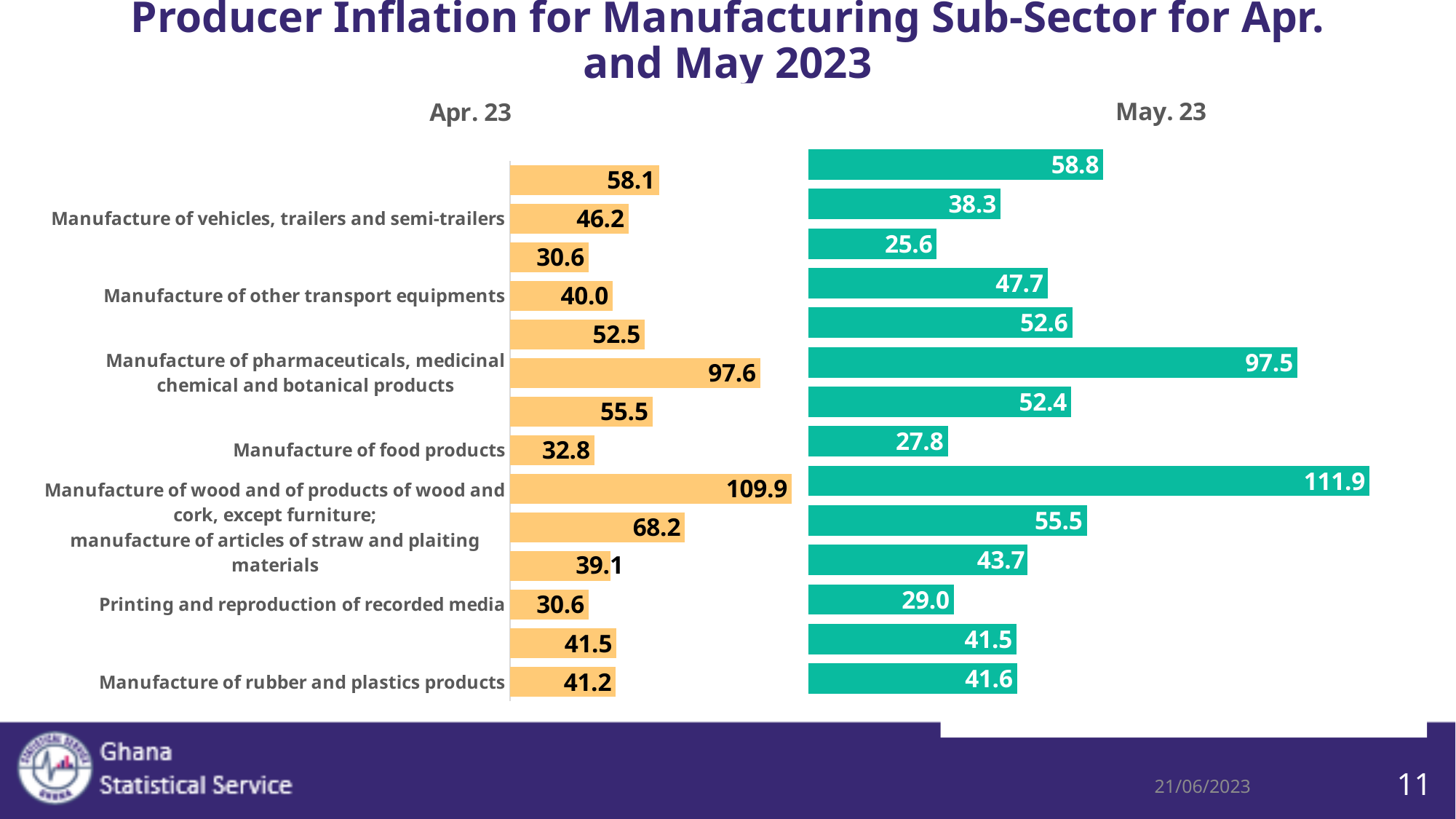
What kind of chart is used on this slide for the Apr. 23 and May. 23 data? Bar chart How many bars are plotted in the Apr. 23 chart? 14 In the May. 23 chart, what is the value for Manufacture of other transport equipments? 47.7 In the May. 23 chart, what is the lowest value shown? 25.6 In the May. 23 chart, what is the value for Manufacture of food products? 27.8 In the Apr. 23 chart, what is the value for Manufacture of pharmaceuticals, medicinal chemical and botanical products? 97.6 For Manufacture of other transport equipments, which is larger: the Apr. 23 value or the May. 23 value? May. 23 In the Apr. 23 chart, what is the value for Printing and reproduction of recorded media? 30.6 How much higher is the Apr. 23 value than the May. 23 value for Manufacture of vehicles, trailers and semi-trailers? 7.9 In the Apr. 23 chart, what is the highest value shown? 109.9 In the Apr. 23 chart, what is the value for Manufacture of food products? 32.8 In the May. 23 chart, what is the highest value shown? 111.9